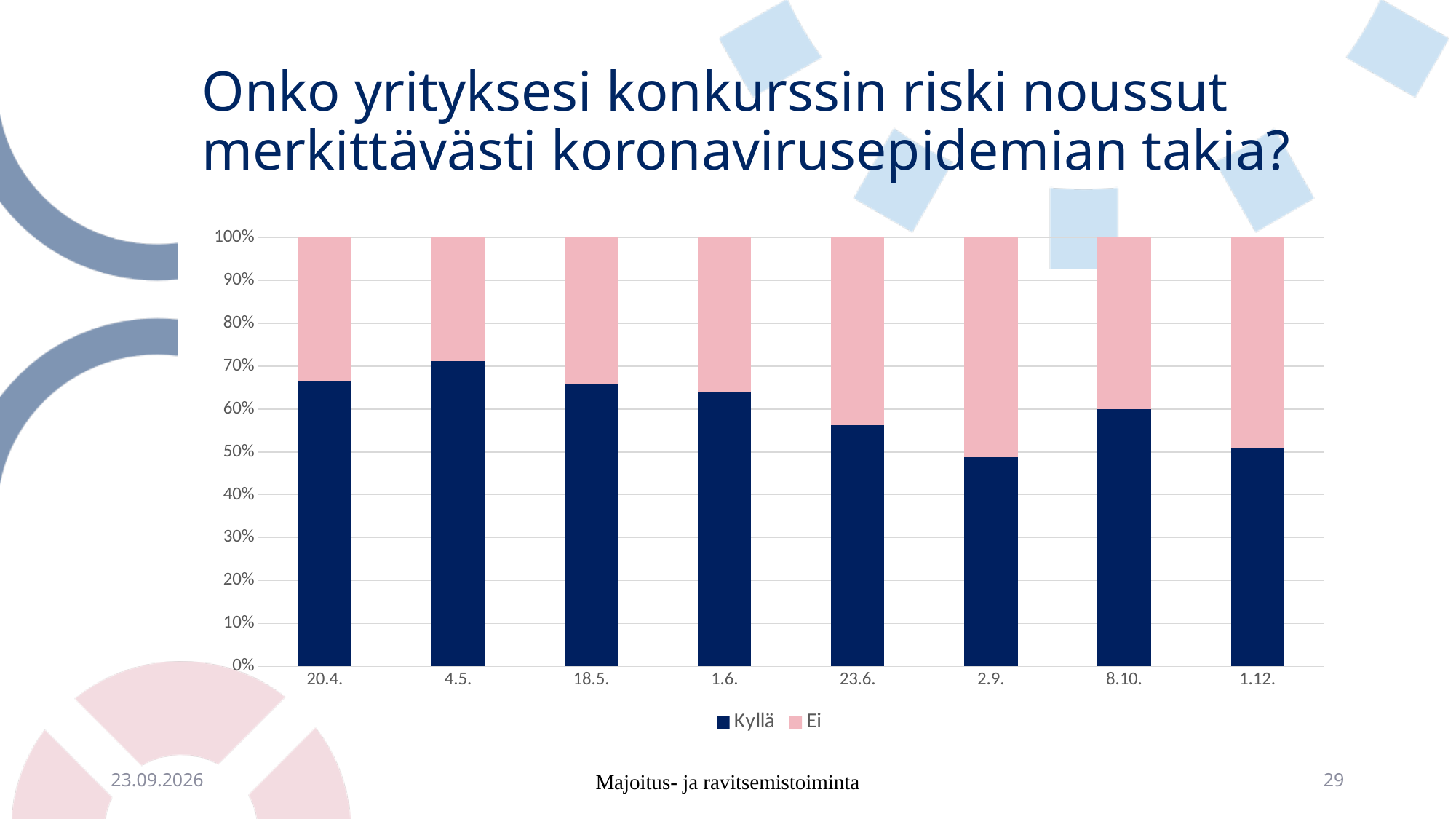
Is the Kyllä share for 23.6. greater or less than 50%? greater Which date has the lowest share of Kyllä? 2.9. Is the Kyllä share for 20.4. greater or less than 70%? less Which has a larger Ei share, 2.9. or 20.4.? 2.9. Which date has the highest share of Kyllä? 4.5. How many dates (categories) are shown on the x axis? 8 Is the Kyllä share for 1.6. greater or less than 60%? greater Does the Kyllä share rise or fall from 4.5. to 2.9.? fall Which colour represents the Ei series? Pink Which has a larger Kyllä share, 4.5. or 2.9.? 4.5. What kind of chart is shown on the slide? Stacked bar chart How many series does the legend list? 2